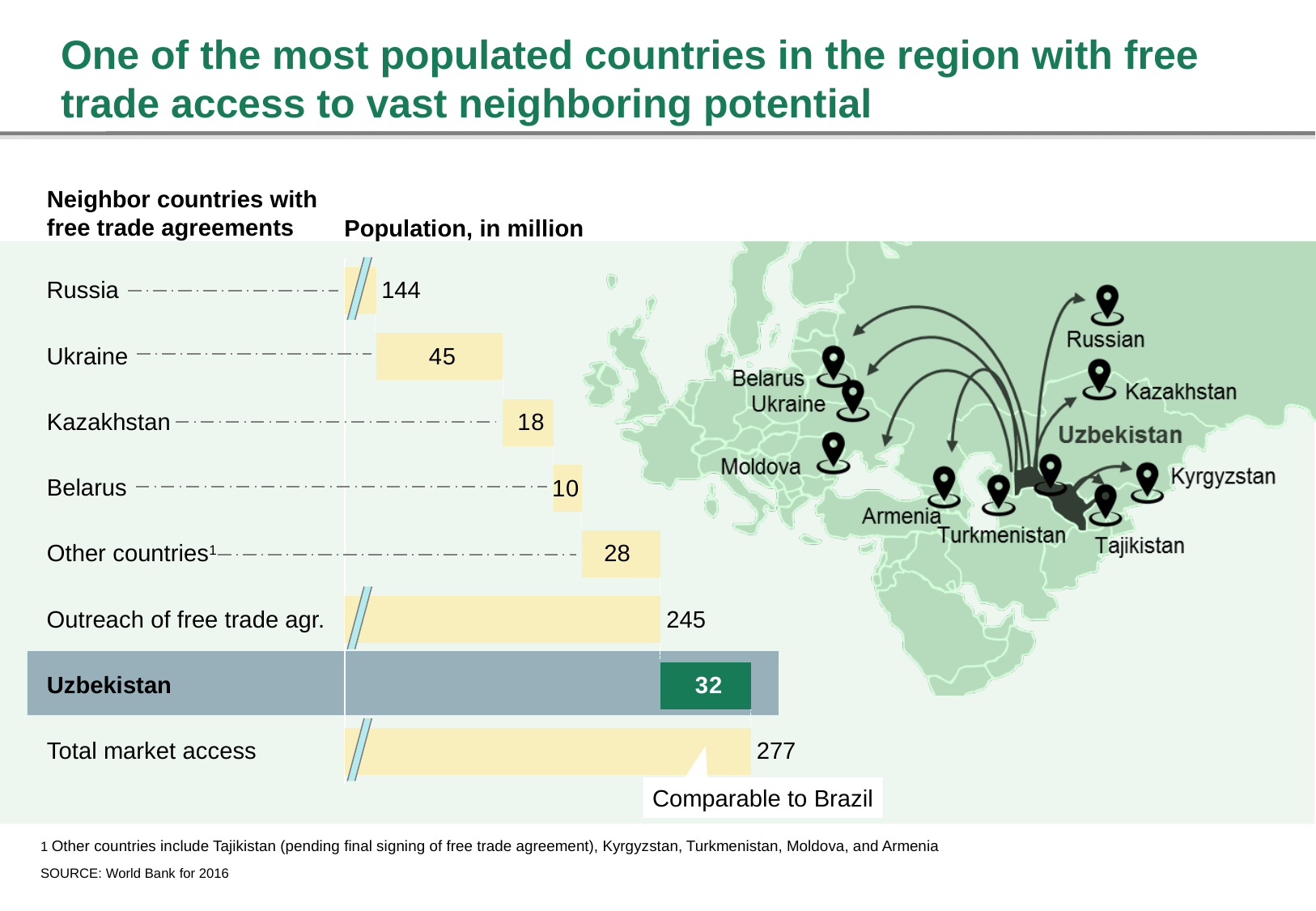
What is the value for Outreach of free trade agr.? 245 What is the total market access described as comparable to? Brazil What is the difference between the populations of Ukraine and Kazakhstan, in million? 27 What unit is the population measured in, according to the chart header? Million What is the value for Total market access? 277 What kind of chart is used to show the population figures? Bar chart What is the population shown for Ukraine, in million? 45 Which has a larger population, Belarus or Other countries? Other countries Which neighbor country with a free trade agreement has the largest population? Russia Which neighbor country with a free trade agreement has the smallest population? Belarus What is the population shown for Russia, in million? 144 What value is shown for Uzbekistan? 32